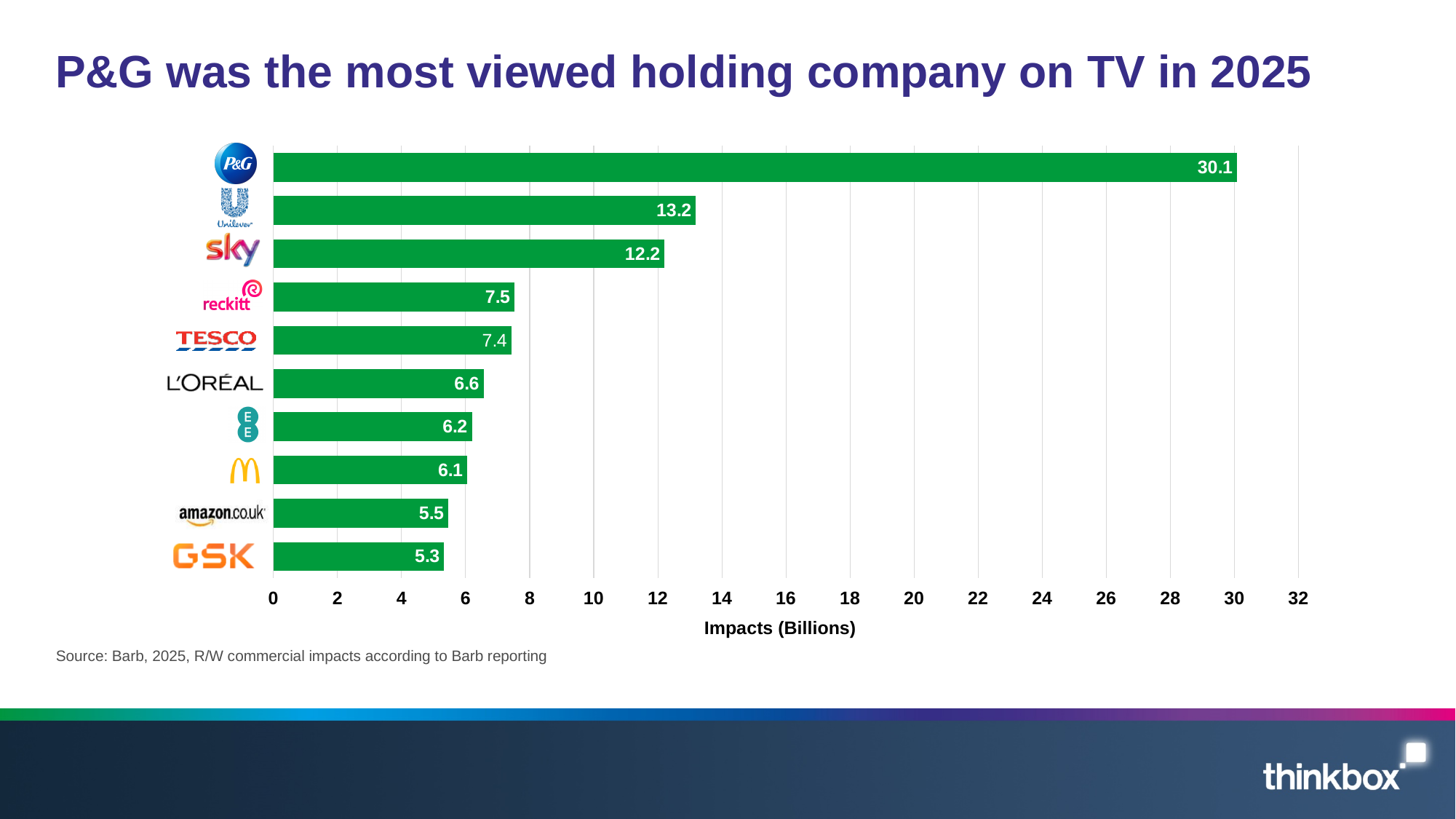
What is the difference between the values for P&G and Unilever? 16.9 What is the difference between the values for Sky and L'Oréal? 5.6 What is the value for P&G? 30.1 How many companies are shown in the chart? 10 What is the label of the horizontal axis? Impacts (Billions) Which company has the lowest value? GSK What is the value for GSK? 5.3 Which company has the highest value? P&G What is the value for Unilever? 13.2 What is the value for Tesco? 7.4 Which has a larger value, Sky or Reckitt? Sky What kind of chart is shown on the slide? Bar chart